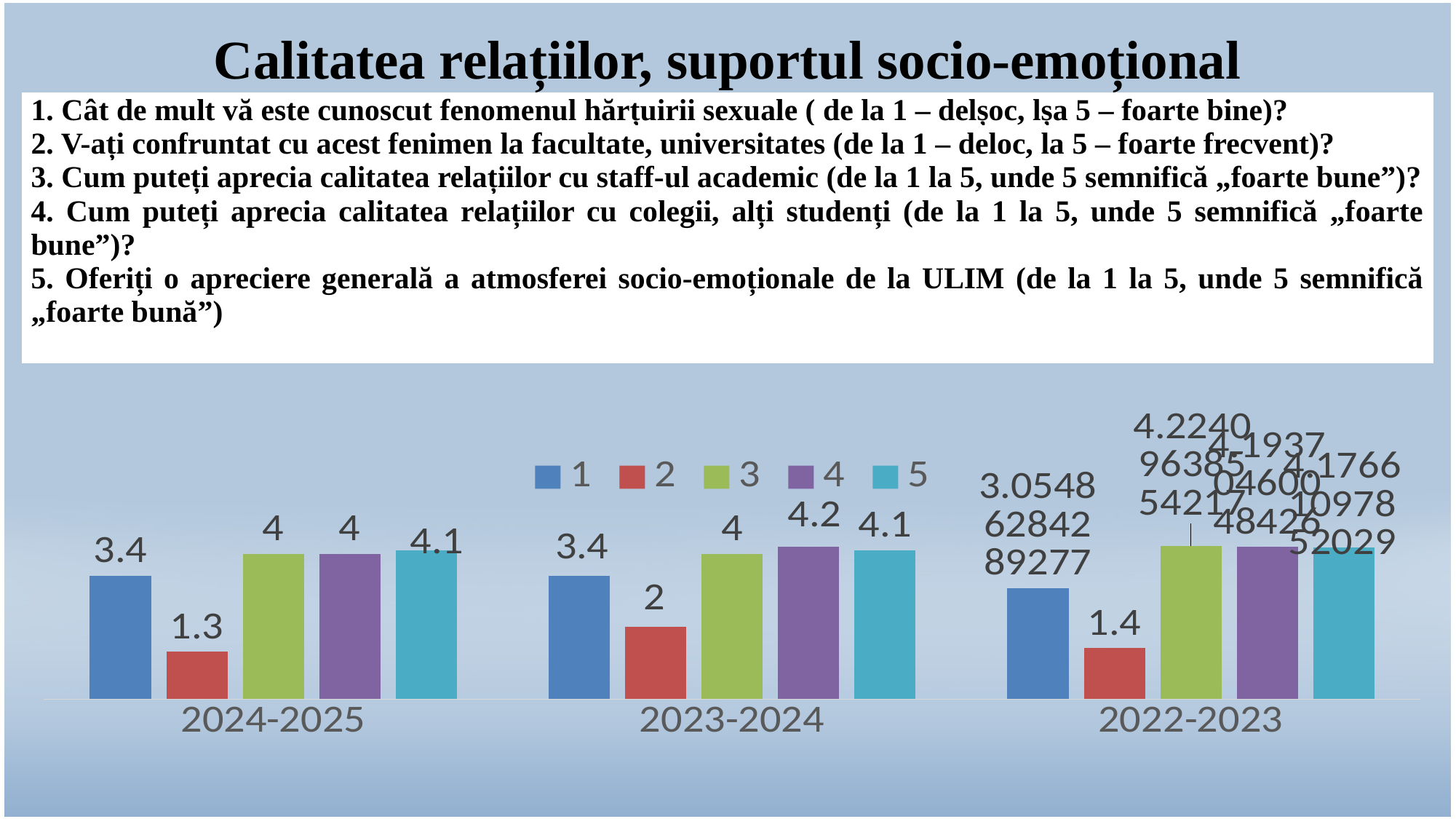
What is the value for series 1 in 2024-2025? 3.4 What kind of chart is shown on the slide? bar chart What is the value for series 2 in 2023-2024? 2 What is the value for series 5 in 2024-2025? 4.1 How many series does the chart legend list? 5 Which is larger in 2023-2024: the value for series 1 or the value for series 2? series 1 How many academic-year categories are shown on the x axis of the chart? 3 What is the value for series 2 in 2024-2025? 1.3 What is the difference between the series 5 value and the series 2 value in 2024-2025? 2.8 What is the value for series 2 in 2022-2023? 1.4 What is the value for series 4 in 2023-2024? 4.2 Which series has the lowest value in 2023-2024? 2